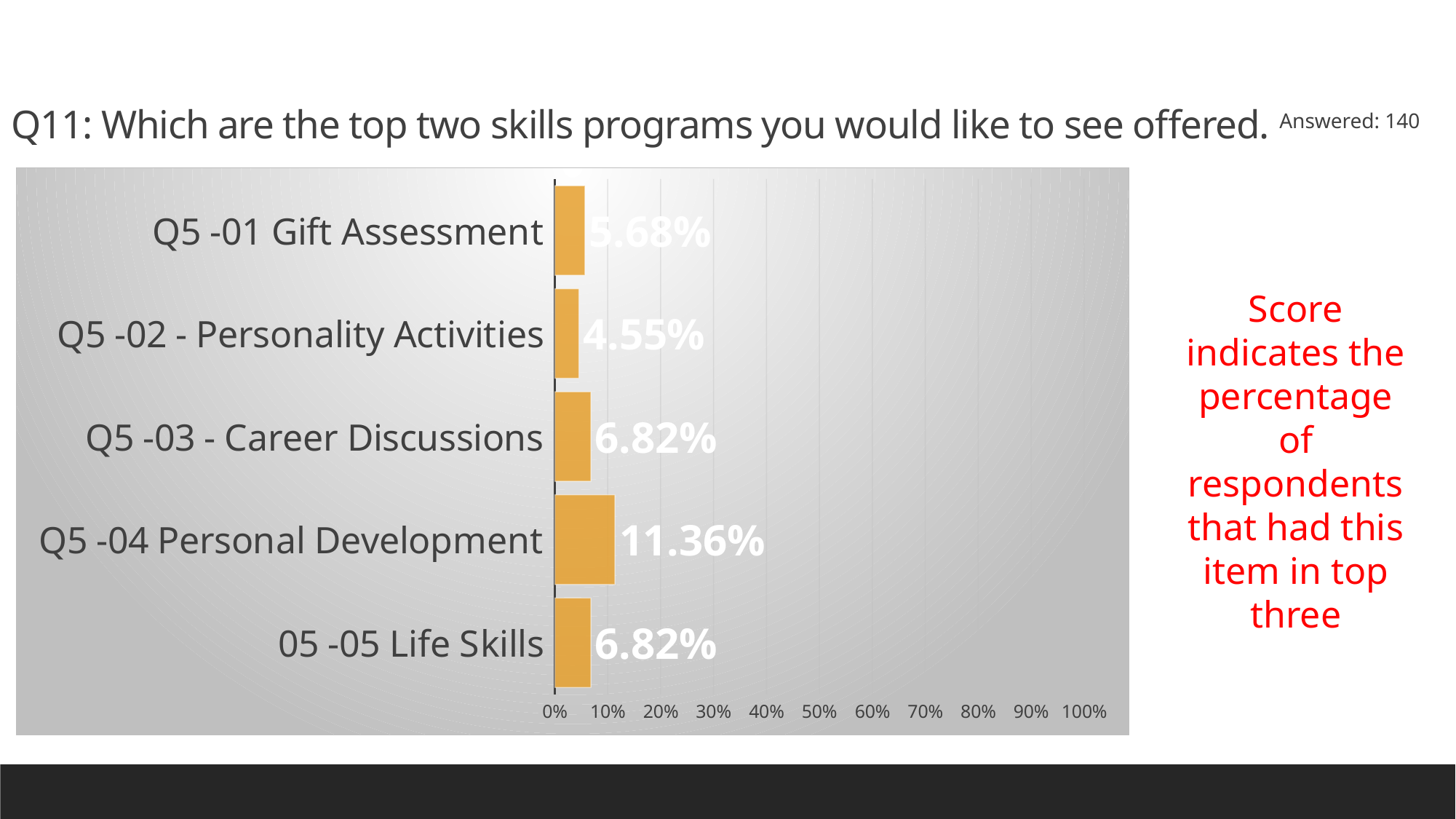
Which is larger, the value for Q5 -01 Gift Assessment or the value for Q5 -03 - Career Discussions? Q5 -03 - Career Discussions Which category has the lowest value? Q5 -02 - Personality Activities What is the difference between the values for Q5 -04 Personal Development and Q5 -02 - Personality Activities? 6.81% What kind of chart is shown on the slide? bar chart What is the value for Q5 -01 Gift Assessment? 5.68% How many respondents answered the question, according to the slide? 140 What is the value for Q5 -04 Personal Development? 11.36% Which category has the highest value? Q5 -04 Personal Development How many categories are shown in the chart? 5 Is the value for Q5 -04 Personal Development greater or less than 10%? greater What is the value for 05 -05 Life Skills? 6.82% What is the value for Q5 -02 - Personality Activities? 4.55%